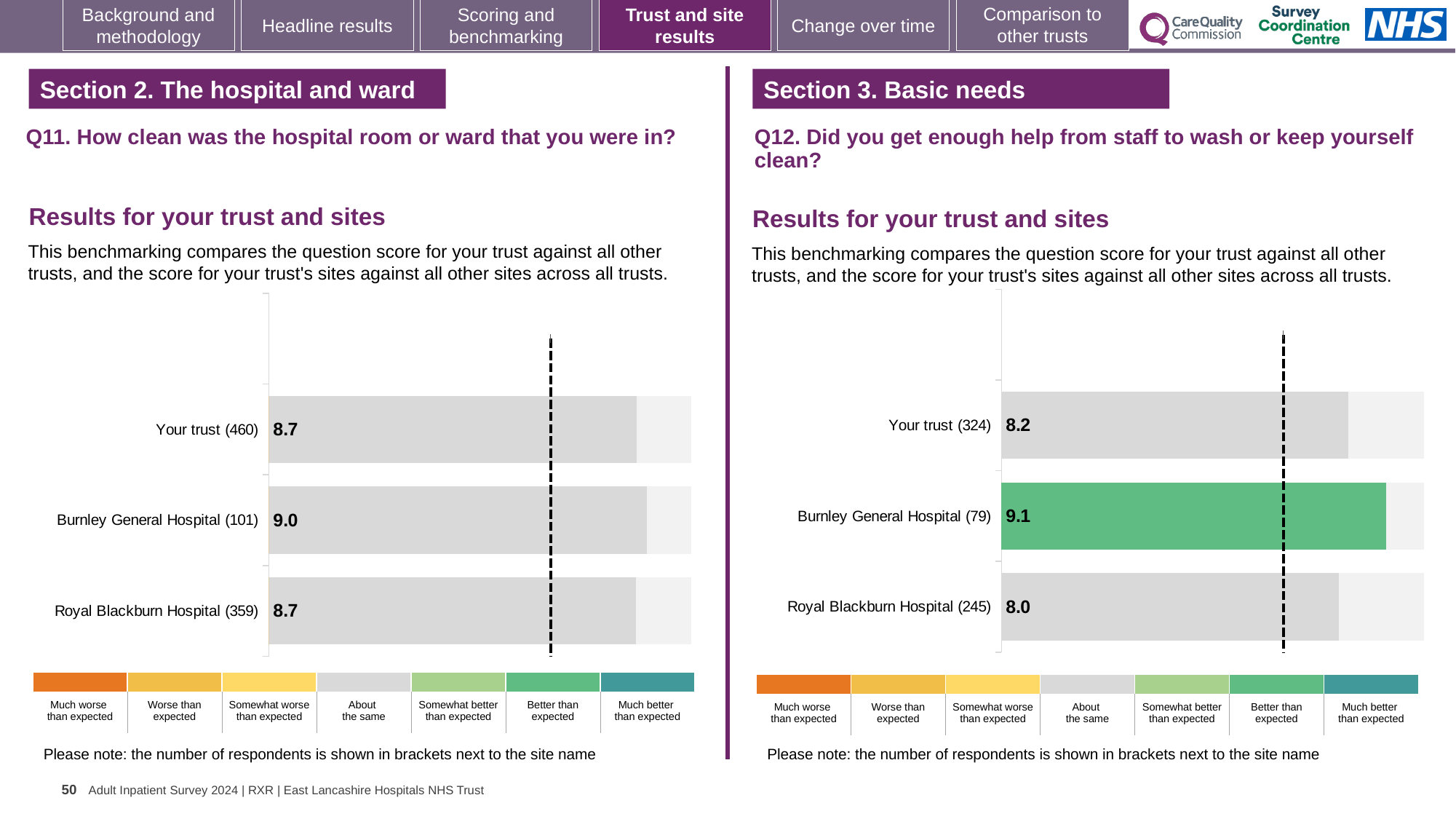
In the Q11 chart (left), what is the score for Your trust? 8.7 In the Q11 chart (left), how many bars are plotted? 3 In the Q12 chart (right), what is the score for Your trust? 8.2 In the Q12 chart (right), which site or trust has the lowest score? Royal Blackburn Hospital In the Q12 chart (right), what is the difference between the Burnley General Hospital score and the Royal Blackburn Hospital score? 1.1 In the Q11 chart (left), which site or trust has the highest score? Burnley General Hospital In the Q12 chart (right), how many respondents are shown in brackets for Burnley General Hospital? 79 In the Q11 chart (left), what is the score for Burnley General Hospital? 9.0 In the Q11 chart (left), what is the difference between the Burnley General Hospital score and the Royal Blackburn Hospital score? 0.3 In the Q12 chart (right), what is the score for Royal Blackburn Hospital? 8.0 What kind of chart is used on the left side of the slide for Q11? Bar chart In the Q12 chart (right), which is larger: the score for Burnley General Hospital or the score for Your trust? Burnley General Hospital